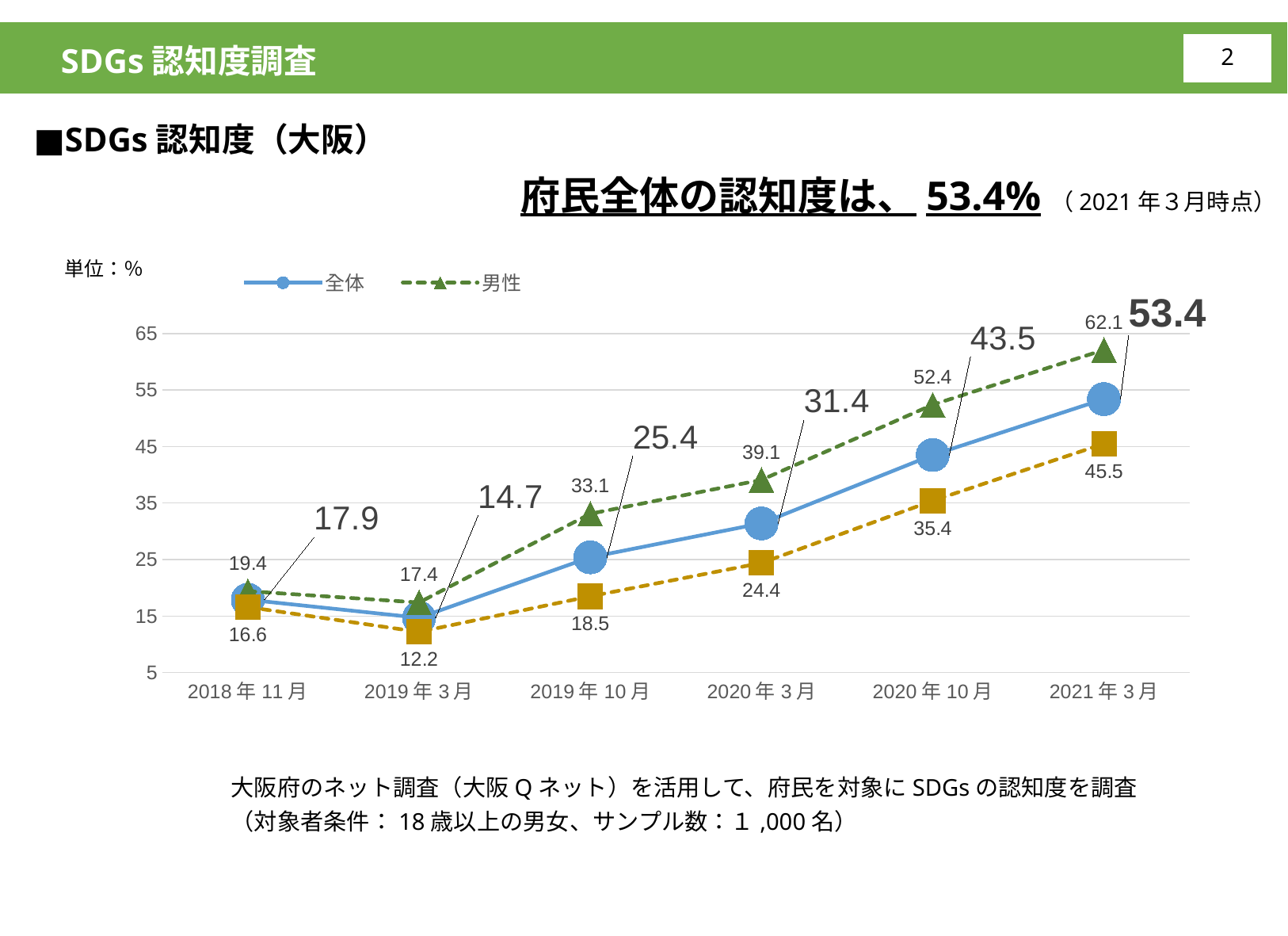
At which time point is the 男性 value highest? 2021年3月 What is the value of 男性 at 2020年10月? 52.4 What is the value of 男性 at 2019年10月? 33.1 How many series does the legend list? 2 What is the difference between the 男性 and 全体 values at 2021年3月? 8.7 How many time points are shown on the x axis? 6 At which time point is the 全体 value lowest? 2019年3月 From 2019年3月 to 2021年3月, does the 全体 value rise or fall? rise What is the value of 全体 at 2021年3月? 53.4 What type of chart is shown on the slide? line chart What is the value of 全体 at 2019年3月? 14.7 Which is larger at 2020年3月, the 全体 value or the 男性 value? 男性